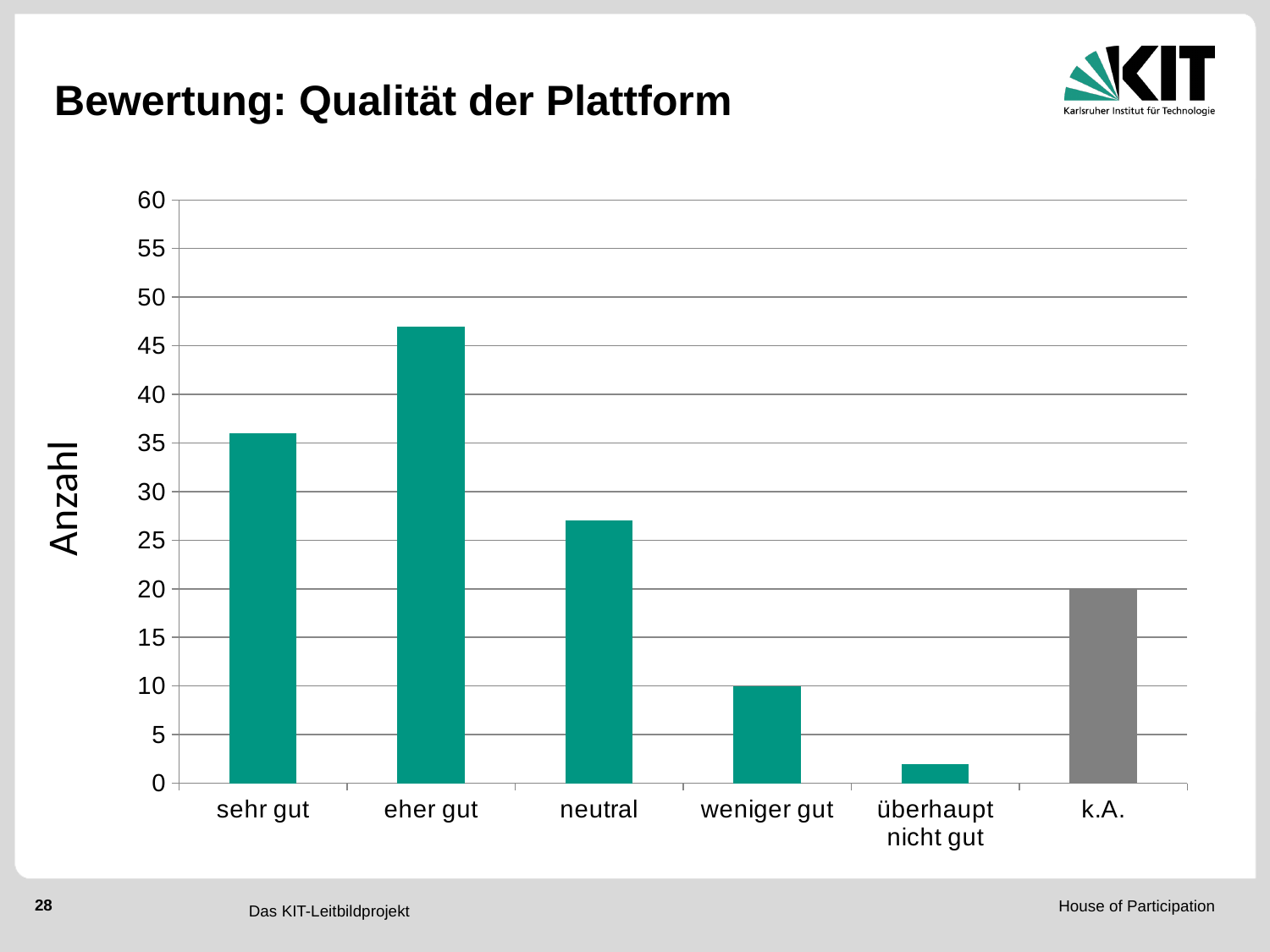
Is the value for 'überhaupt nicht gut' greater or less than 5? less What is the value for 'k.A.' in the chart? 20 What is the label of the y axis of the chart? Anzahl What is the value for 'weniger gut' in the chart? 10 Is the value for 'neutral' greater or less than 25? greater Is the value for 'eher gut' greater or less than 50? less How many categories are shown on the x axis of the chart? 6 What kind of chart is shown on the slide? bar chart Which is larger, the value for 'sehr gut' or the value for 'neutral'? sehr gut Which category has the lowest bar in the chart? überhaupt nicht gut Which category has the highest bar in the chart? eher gut